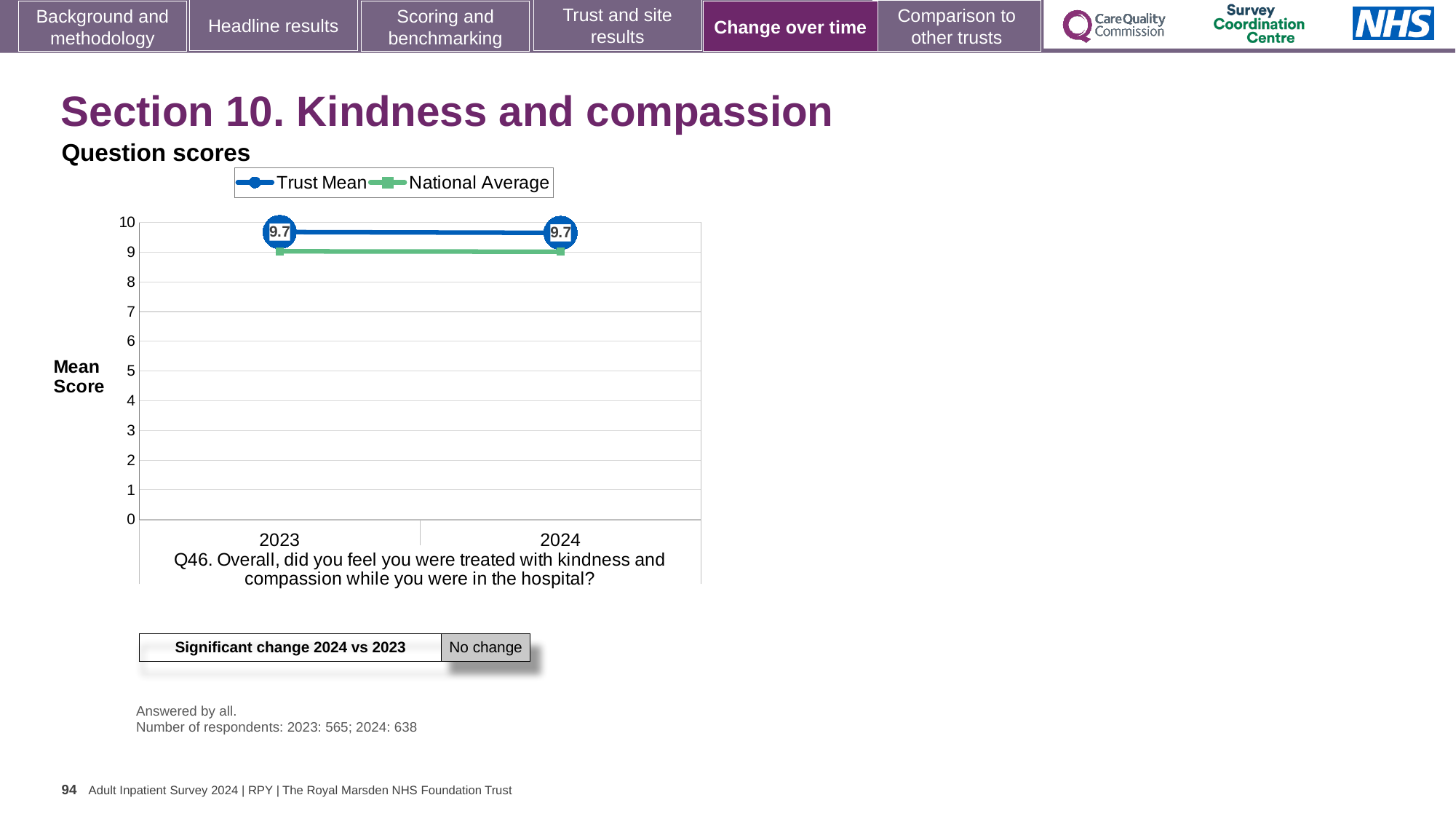
Does the Trust Mean rise, fall or stay the same from 2023 to 2024? stays the same How many years are plotted on the x axis? 2 How many series does the legend list? 2 What is the label of the y axis? Mean Score What is the Trust Mean score for 2024? 9.7 What kind of chart is shown on the slide? line chart Is the National Average for 2023 greater or less than 8? greater Is the National Average for 2024 greater or less than 9.5? less What is the Trust Mean score for 2023? 9.7 What is the difference between the Trust Mean scores for 2024 and 2023? 0 Which question does the chart show scores for? Q46. Overall, did you feel you were treated with kindness and compassion while you were in the hospital? Which series is higher in 2024, Trust Mean or National Average? Trust Mean